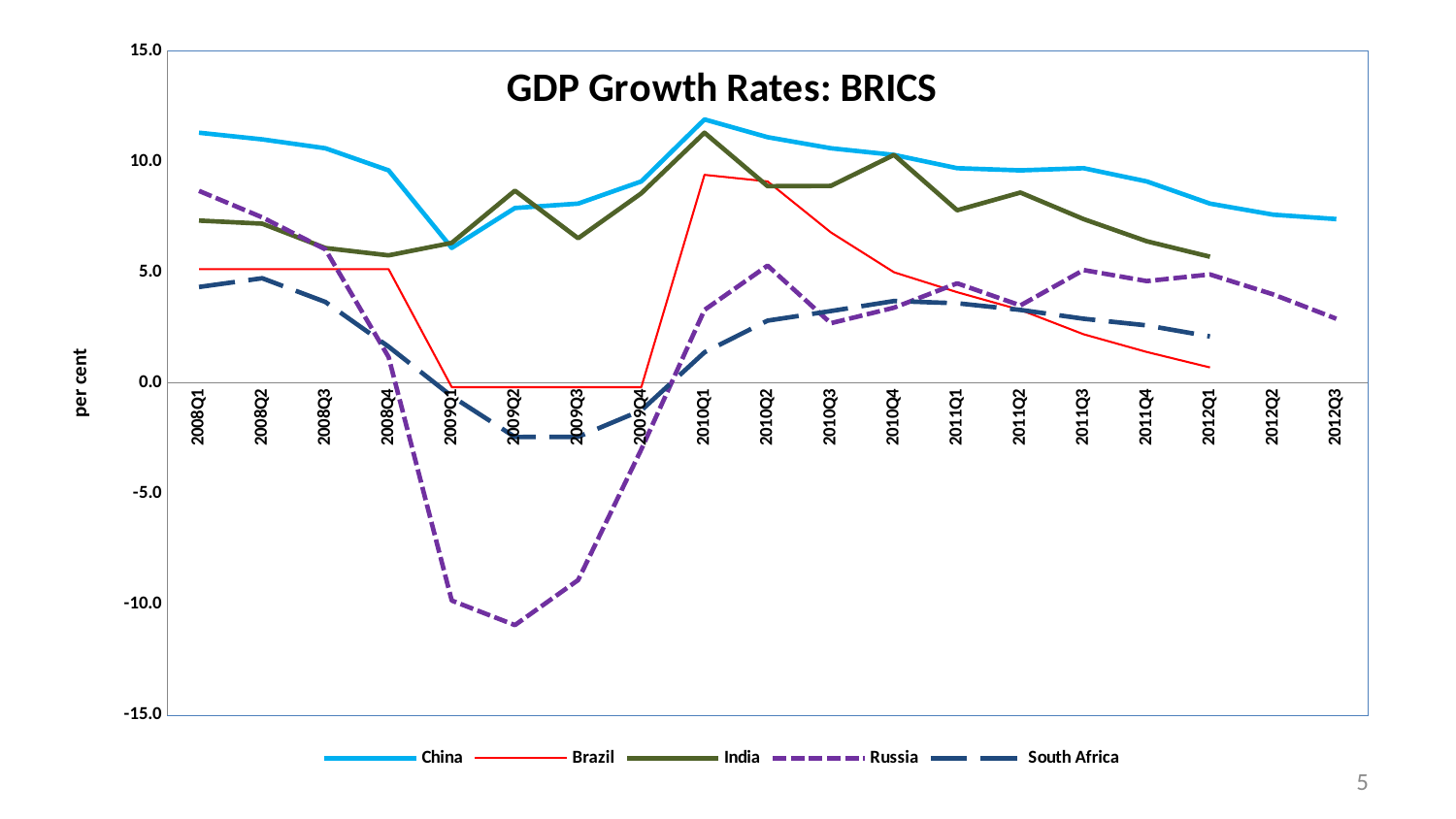
What is the label on the vertical axis? per cent What is the title of the chart? GDP Growth Rates: BRICS Which series reaches the lowest value anywhere on the chart? Russia Which series has the highest value in 2008Q1? China Is the value for Russia in 2009Q2 greater or less than -5.0? less How many quarters are shown along the x axis? 19 Does the value for China rise or fall from 2010Q1 to 2012Q3? fall Is the value for Brazil in 2010Q1 greater or less than 5.0? greater Is the value for China in 2008Q1 greater or less than 10.0? greater What kind of chart is shown on the slide? line chart How many series does the legend list? 5 In 2009Q1, which is larger, the value for China or the value for Brazil? China